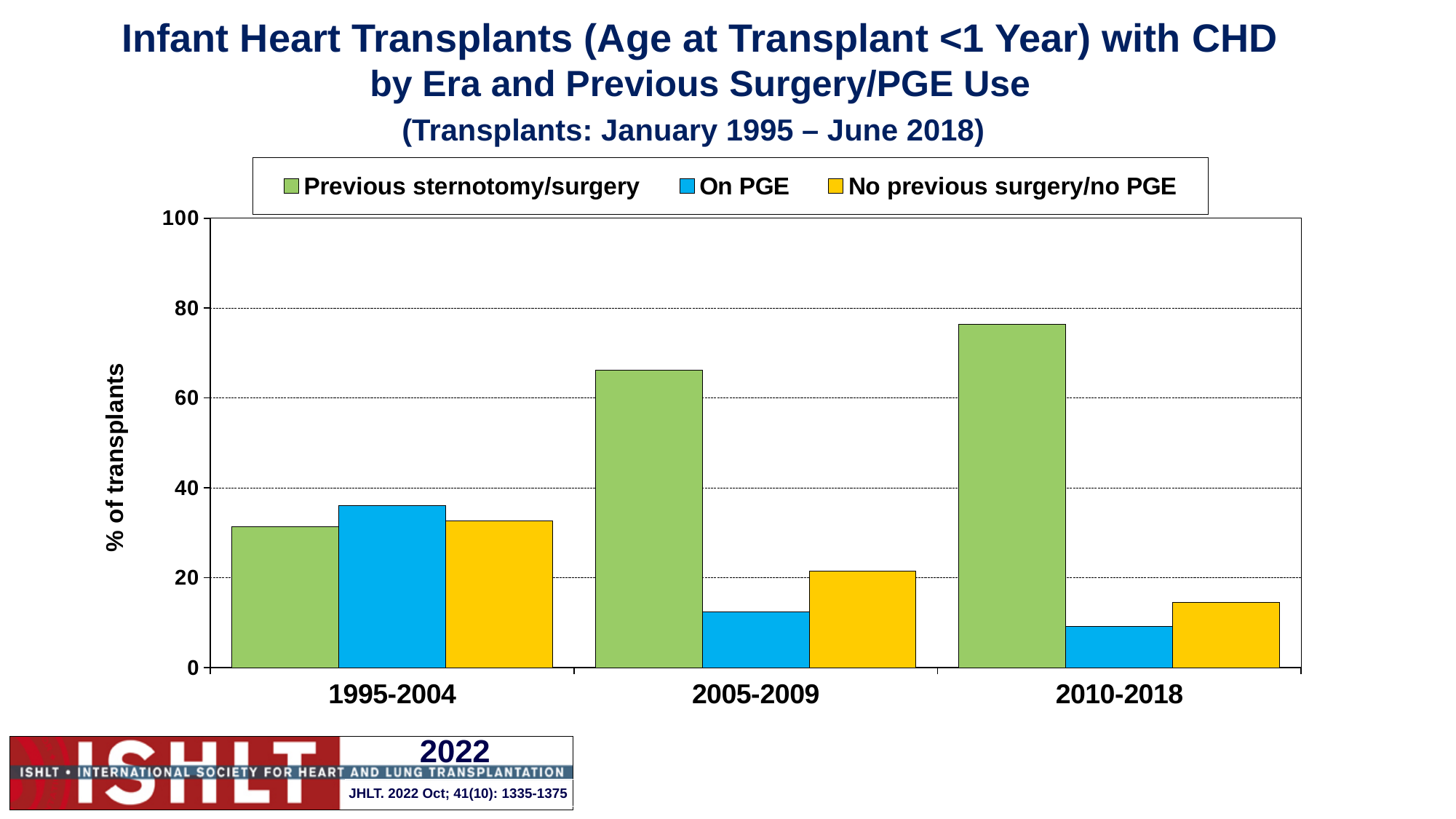
Which era has the highest value for No previous surgery/no PGE? 1995-2004 What kind of chart is shown on the slide? bar chart Which era has the highest value for Previous sternotomy/surgery? 2010-2018 Does the value for Previous sternotomy/surgery rise or fall across the eras from 1995-2004 to 2010-2018? rise Is the value for Previous sternotomy/surgery in 2005-2009 greater or less than 60? greater How many era categories are shown on the x axis? 3 How many series does the legend list? 3 What is the label of the y axis? % of transplants Is the value for Previous sternotomy/surgery in 2010-2018 greater or less than 80? less Which era has the lowest value for On PGE? 2010-2018 Which is larger in 2005-2009: On PGE or No previous surgery/no PGE? No previous surgery/no PGE Is the value for On PGE in 2010-2018 greater or less than 20? less